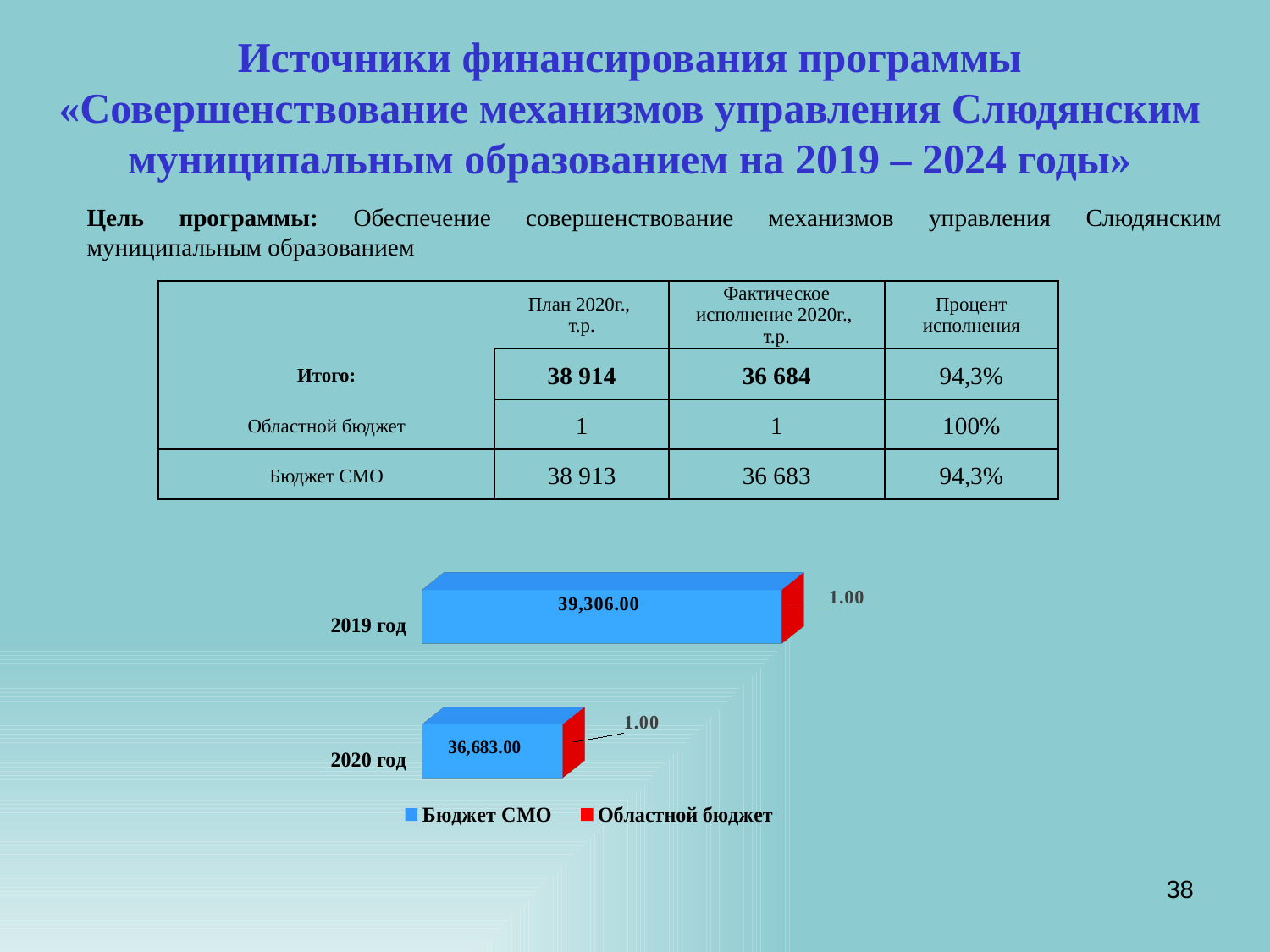
What type of chart is shown on the slide? bar chart How many series does the chart legend list? 2 Which series is shown in red in the chart? Областной бюджет How many categories (years) are plotted in the chart? 2 What is the value of Бюджет СМО for 2019 год in the chart? 39,306.00 What is the total of the stacked bar for 2020 год in the chart? 36,684.00 Which year has the higher Бюджет СМО value in the chart? 2019 год What is the value of Бюджет СМО for 2020 год in the chart? 36,683.00 What is the value of Областной бюджет for 2020 год in the chart? 1.00 What is the value of Областной бюджет for 2019 год in the chart? 1.00 What is the difference between the Бюджет СМО values for 2019 год and 2020 год in the chart? 2,623.00 Which year has the lower Бюджет СМО value in the chart? 2020 год